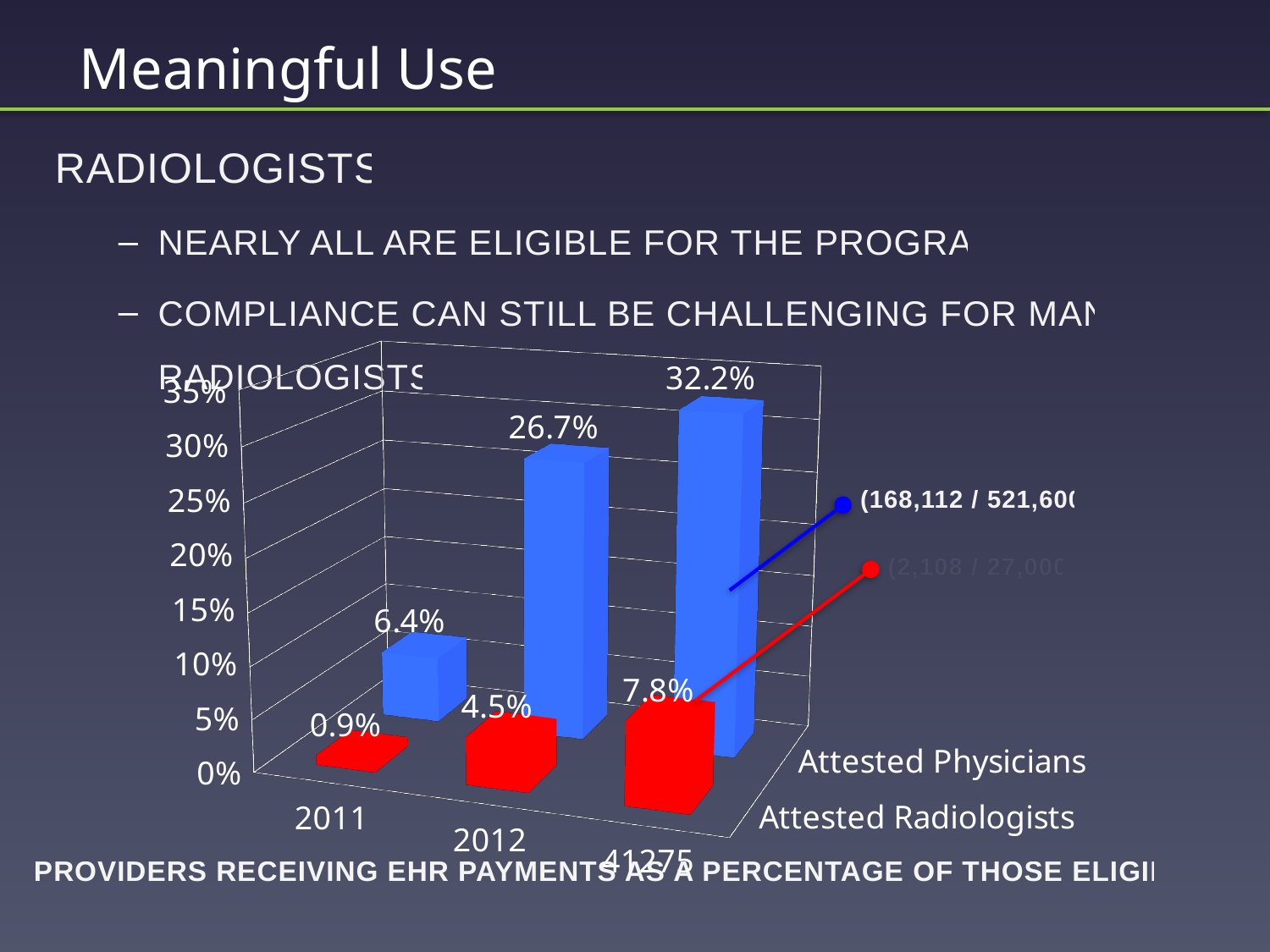
How many categories are shown on the x axis? 3 What kind of chart is shown on the slide? Bar chart What is the difference between the Attested Physicians values for 2012 and 2011? 20.3% What is the value for Attested Physicians in 2012? 26.7% Which category has the lowest value for Attested Radiologists? 2011 Which is larger in 2012: Attested Physicians or Attested Radiologists? Attested Physicians Which category has the highest value for Attested Physicians? 41275 Do the Attested Radiologists values rise or fall from 2011 to the last category? Rise What is the value for Attested Radiologists in 2012? 4.5% What is the value for Attested Physicians in 2011? 6.4% How many series does the chart show? 2 What is the value for Attested Radiologists in 2011? 0.9%